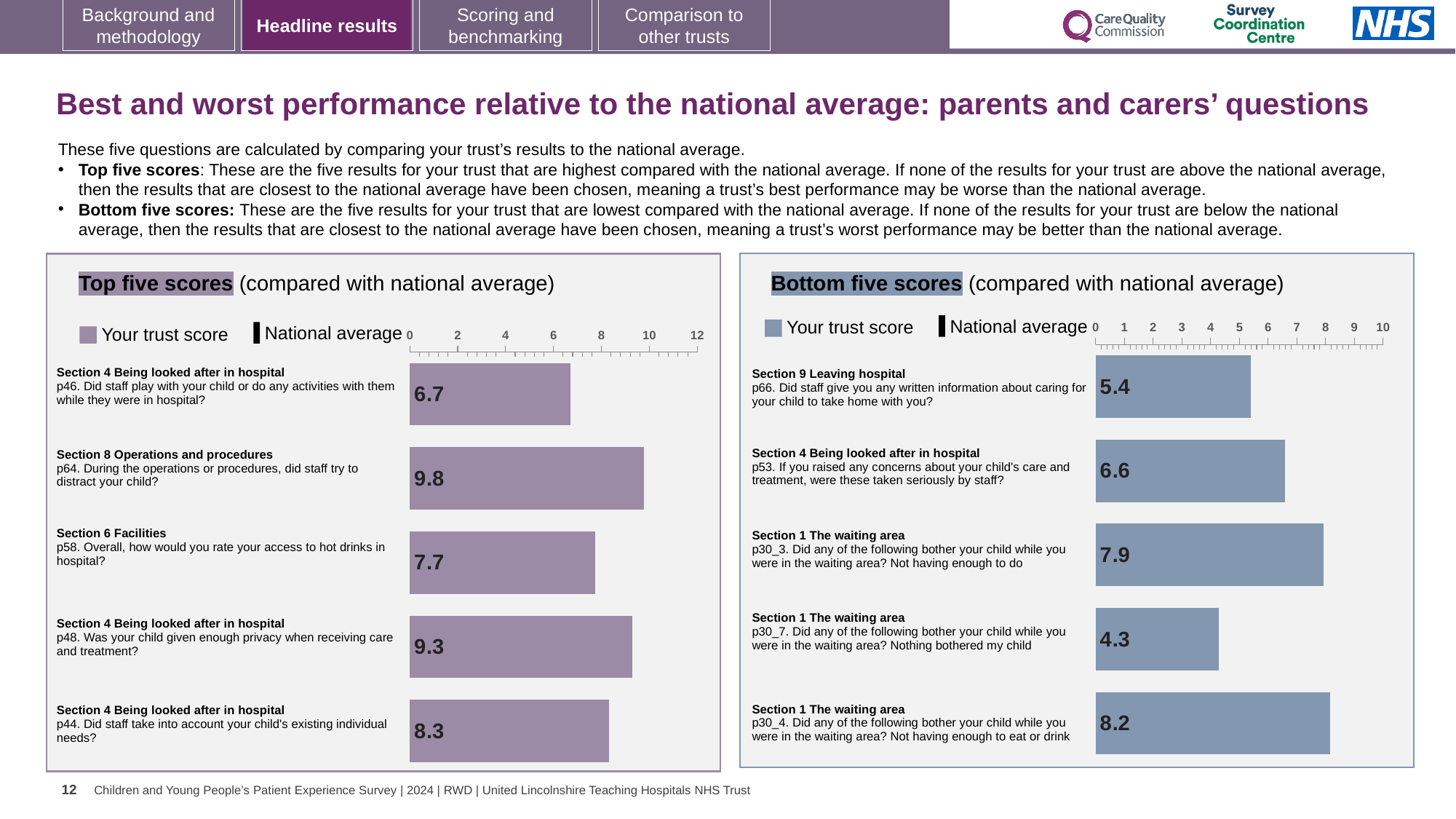
What is the maximum value shown on the x axis of the Bottom five scores chart? 10 In the Top five scores chart, which has the larger trust score: p48 or p44? p48 In the Bottom five scores chart, what is the difference between the trust scores for p30_3 and p30_7? 3.6 In the Bottom five scores chart, what is the trust score for p66 (Did staff give you any written information about caring for your child to take home with you?)? 5.4 In the Top five scores chart, what is the difference between the trust scores for p64 and p46? 3.1 What type of chart is the Top five scores chart? Bar chart In the Top five scores chart, what is the trust score for p64 (During the operations or procedures, did staff try to distract your child?)? 9.8 In the Top five scores chart, which question has the highest trust score? p64. During the operations or procedures, did staff try to distract your child? In the Bottom five scores chart, what is the trust score for p30_4 (Not having enough to eat or drink)? 8.2 In the Top five scores chart, what is the trust score for p58 (Overall, how would you rate your access to hot drinks in hospital?)? 7.7 How many questions are shown in the Bottom five scores chart? 5 In the Bottom five scores chart, which question has the lowest trust score? p30_7. Did any of the following bother your child while you were in the waiting area? Nothing bothered my child